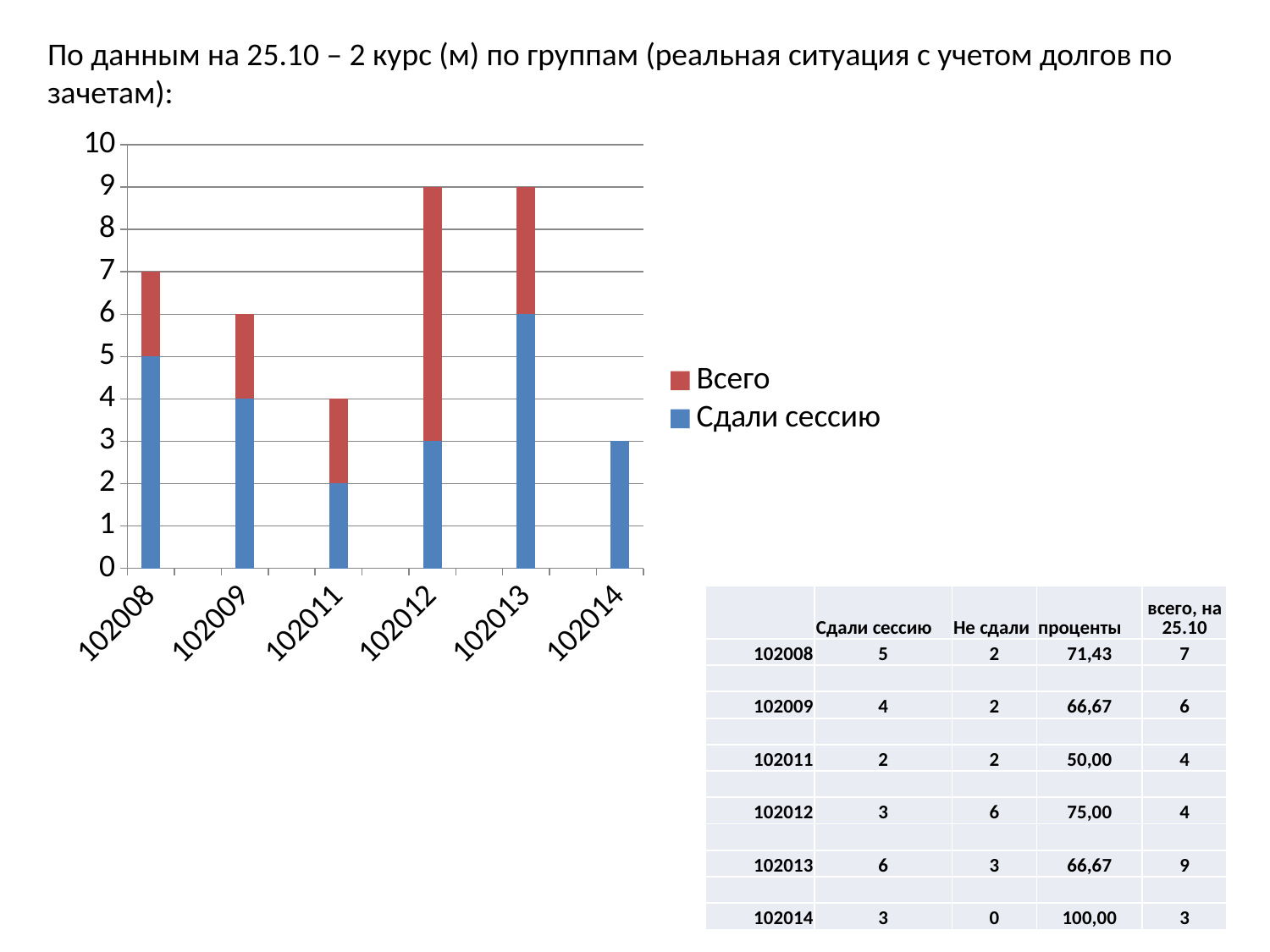
What is the value of the 'Сдали сессию' series for group 102011? 2 Which series is shown in red in the chart legend? Всего How many groups (categories) are shown on the x axis of the chart? 6 Which group has the lowest 'Сдали сессию' value in the chart? 102011 What kind of chart is shown on the slide? stacked bar chart What is the value of the 'Сдали сессию' series for group 102013? 6 What is the total height of the stacked bar for group 102009? 6 Which is larger: the 'Сдали сессию' value for 102008 or for 102014? 102008 What is the value of the 'Сдали сессию' series for group 102008? 5 What is the total height of the stacked bar for group 102012? 9 How many series does the chart legend list? 2 Which group has the highest 'Сдали сессию' value in the chart? 102013